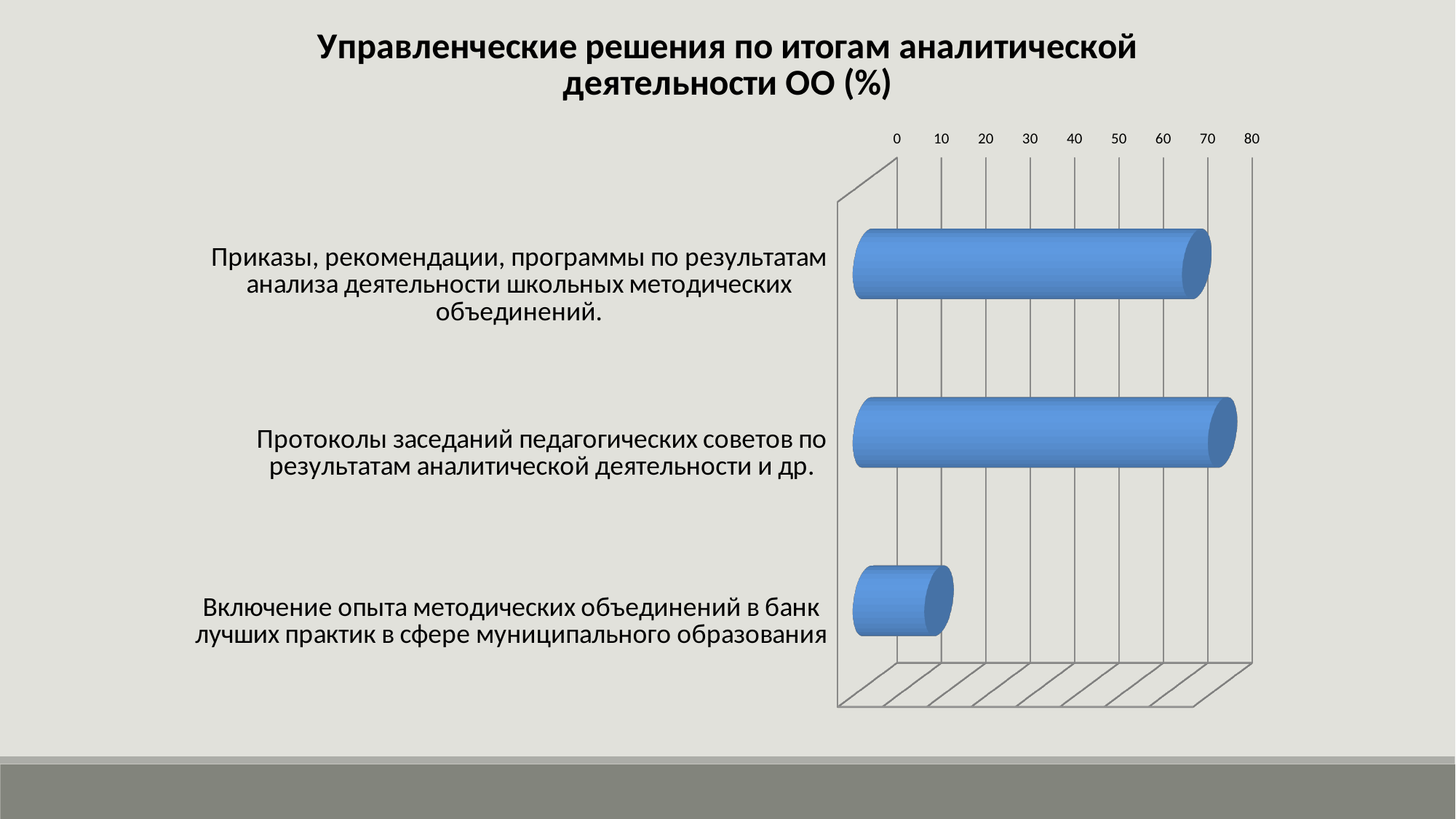
Is the value for "Протоколы заседаний педагогических советов по результатам аналитической деятельности и др." greater or less than 70? greater How many categories are plotted in the chart? 3 Which is larger: the value for "Приказы, рекомендации, программы..." or the value for "Протоколы заседаний педагогических советов..."? Протоколы заседаний педагогических советов по результатам аналитической деятельности и др. Which category has the highest value? Протоколы заседаний педагогических советов по результатам аналитической деятельности и др. Which category has the lowest value? Включение опыта методических объединений в банк лучших практик в сфере муниципального образования What is the maximum value shown on the value axis? 80 Is the value for "Приказы, рекомендации, программы по результатам анализа деятельности школьных методических объединений." greater or less than 60? greater Is the value for "Включение опыта методических объединений в банк лучших практик в сфере муниципального образования" greater or less than 20? less What kind of chart is shown on the slide? bar chart What is the title of the chart? Управленческие решения по итогам аналитической деятельности ОО (%)